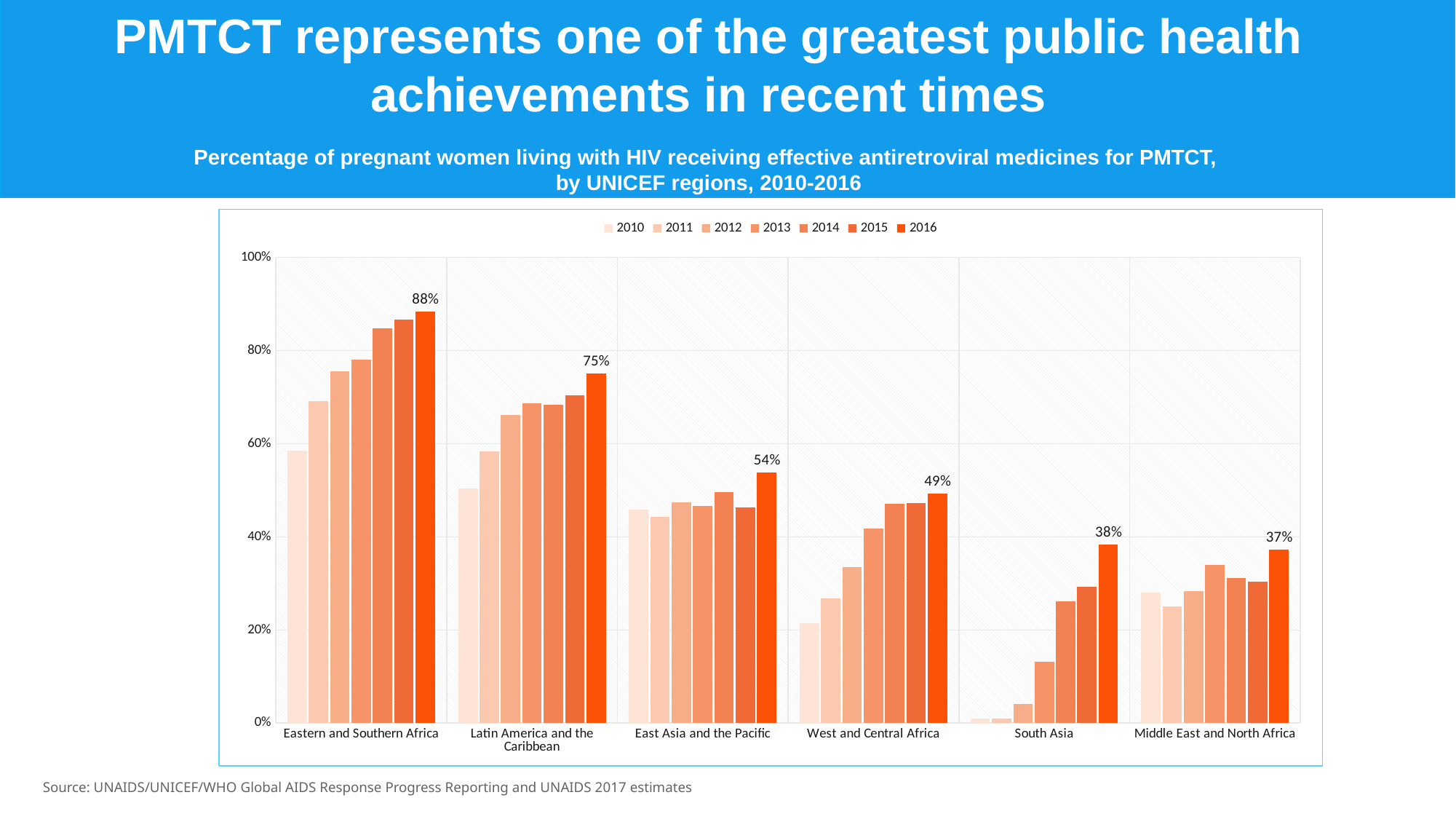
How many regions are shown on the x axis? 6 What is the 2016 value for Latin America and the Caribbean? 75% Which region has the lowest 2016 value? Middle East and North Africa Do the values for Eastern and Southern Africa rise or fall from 2010 to 2016? rise Which has the larger 2016 value, East Asia and the Pacific or West and Central Africa? East Asia and the Pacific Is the 2010 value for South Asia greater or less than 20%? less What is the difference between the 2016 values for Eastern and Southern Africa and Latin America and the Caribbean? 13 percentage points Which region has the highest 2016 value? Eastern and Southern Africa Is the 2010 value for West and Central Africa greater or less than 40%? less What is the 2016 value for Eastern and Southern Africa? 88% How many years does the legend list? 7 What is the 2016 value for South Asia? 38%